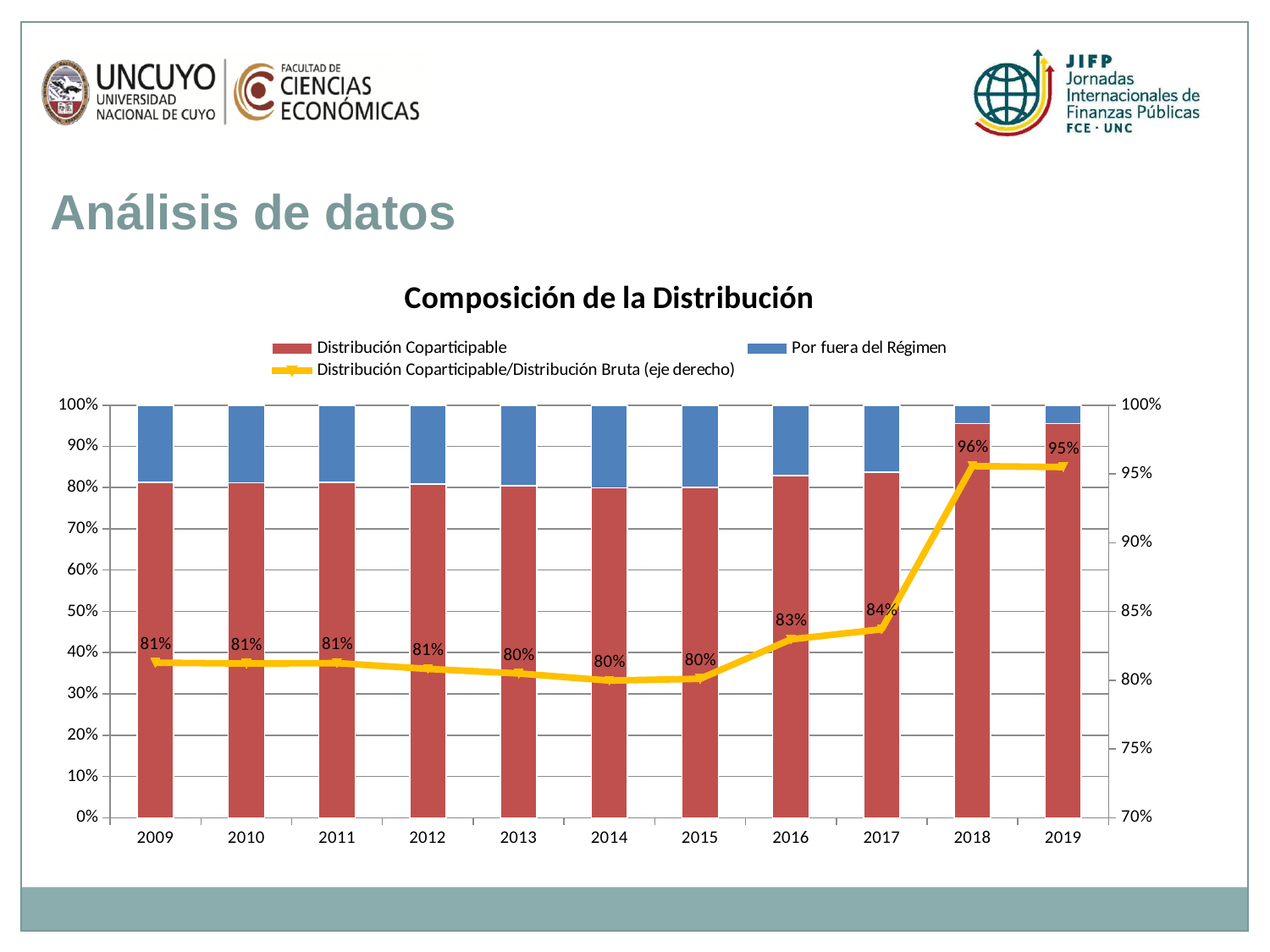
What is the value of the Distribución Coparticipable/Distribución Bruta line for 2009? 81% What is the value of the Distribución Coparticipable/Distribución Bruta line for 2018? 96% How many series does the chart legend list? 3 Is the Distribución Coparticipable bar for 2018 greater or less than 90% on the left axis? greater What is the title of the chart? Composición de la Distribución In which year does the Distribución Coparticipable/Distribución Bruta line reach its highest value? 2018 Which year has a higher Distribución Coparticipable/Distribución Bruta value, 2016 or 2017? 2017 Is the Distribución Coparticipable bar for 2014 greater or less than 90% on the left axis? less What is the difference between the Distribución Coparticipable/Distribución Bruta values for 2018 and 2009? 15 percentage points What is the value of the Distribución Coparticipable/Distribución Bruta line for 2016? 83% How many years are shown on the x axis of the chart? 11 What kind of chart is shown on the slide? Stacked bar chart with a line